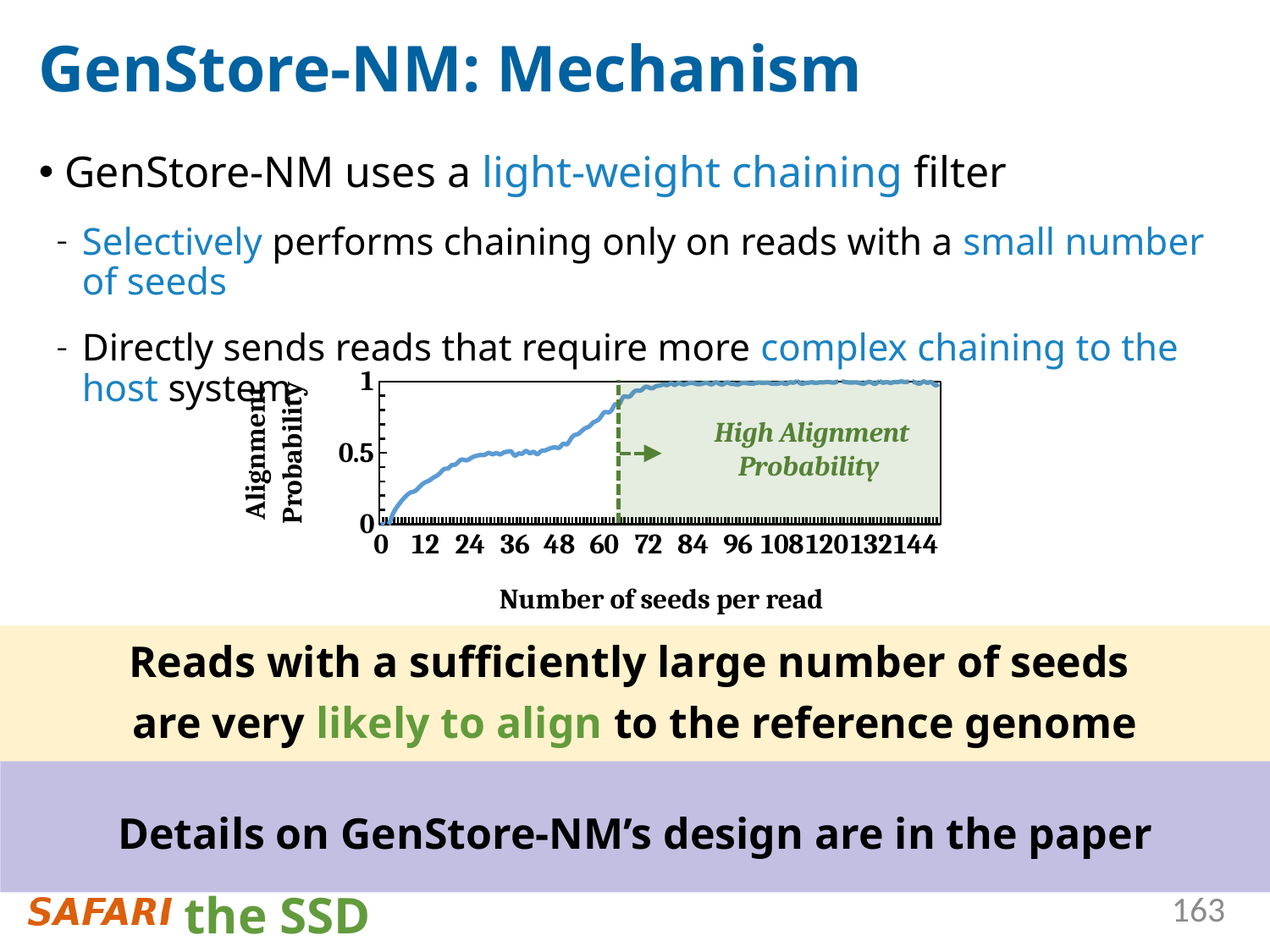
Is the alignment probability at 96 seeds per read greater or less than 0.5? greater How many tick labels are shown on the x axis of the chart? 13 What is the highest tick value shown on the y axis of the chart? 1 Which has a higher alignment probability: 12 seeds per read or 96 seeds per read? 96 seeds per read Is the alignment probability at 12 seeds per read greater or less than 0.5? less What is the label of the x axis of the chart? Number of seeds per read Is the alignment probability at 132 seeds per read greater or less than 0.5? greater What is the highest tick value shown on the x axis of the chart? 144 What is the label of the y axis of the chart? Alignment Probability Does the alignment probability rise or fall as the number of seeds per read increases? rise What kind of chart is shown on the slide? line chart